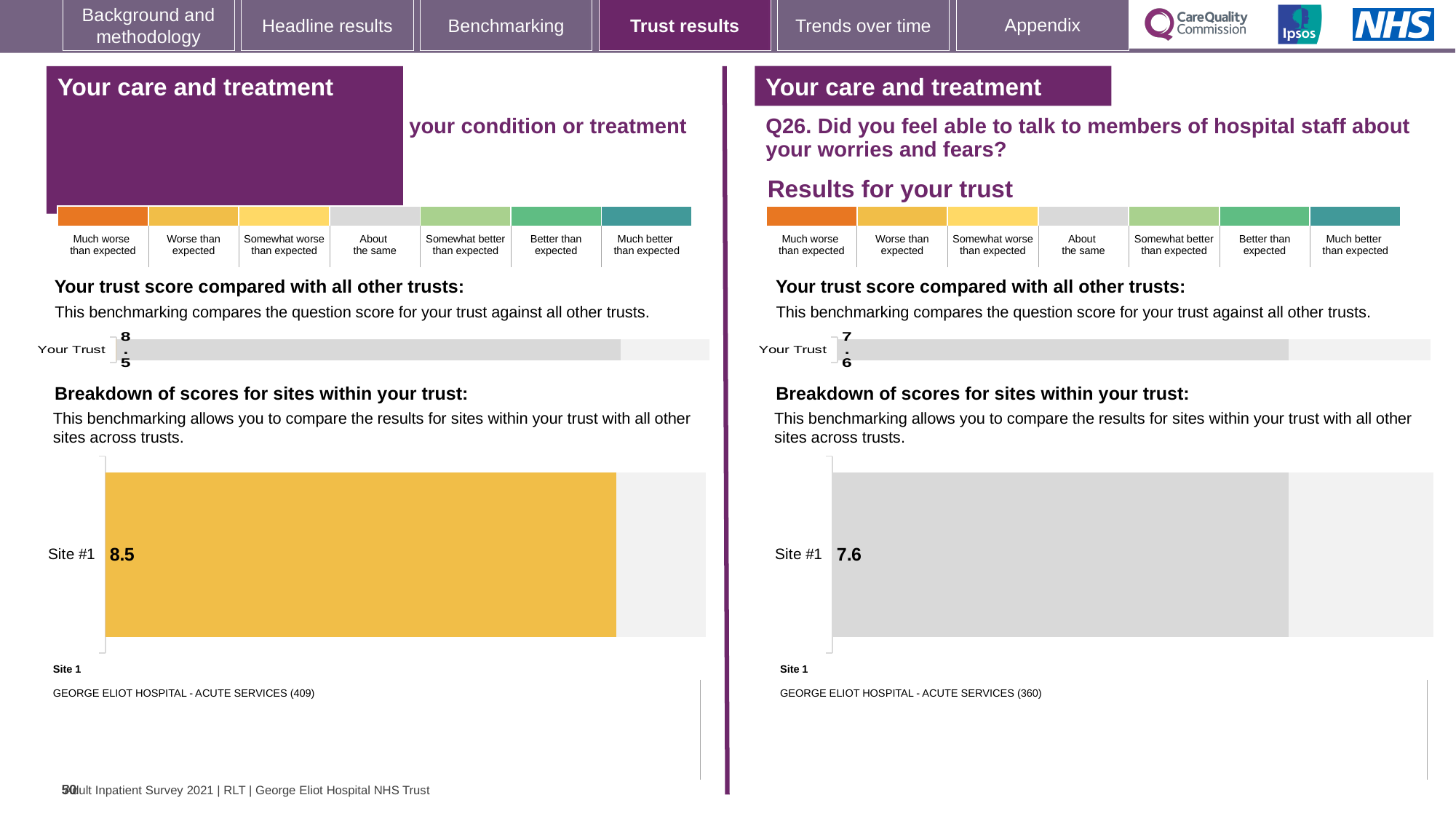
How many sites are plotted in the right 'Breakdown of scores for sites within your trust' chart (Q26)? 1 In the right 'Breakdown of scores for sites within your trust' chart (Q26), what is the value for Site #1? 7.6 What type of chart is used for the 'Breakdown of scores for sites within your trust' on the left half of the slide? Bar chart On the left half of the slide, what is the score shown for Your Trust in the 'Your trust score compared with all other trusts' chart? 8.5 How many sites are plotted in the left 'Breakdown of scores for sites within your trust' chart? 1 In the left 'Breakdown of scores for sites within your trust' chart, what is the value for Site #1? 8.5 Which site name is listed as Site 1 below the right breakdown chart (Q26)? GEORGE ELIOT HOSPITAL - ACUTE SERVICES (360) On the right half of the slide (Q26), what is the score shown for Your Trust in the 'Your trust score compared with all other trusts' chart? 7.6 What colour is the Site #1 bar in the right 'Breakdown of scores for sites within your trust' chart (Q26)? Grey Which is larger: the Site #1 score in the left breakdown chart or the Site #1 score in the right breakdown chart (Q26)? Left (8.5) What colour is the Site #1 bar in the left 'Breakdown of scores for sites within your trust' chart? Yellow What is the difference between the Site #1 score in the left breakdown chart and the Site #1 score in the right breakdown chart (Q26)? 0.9